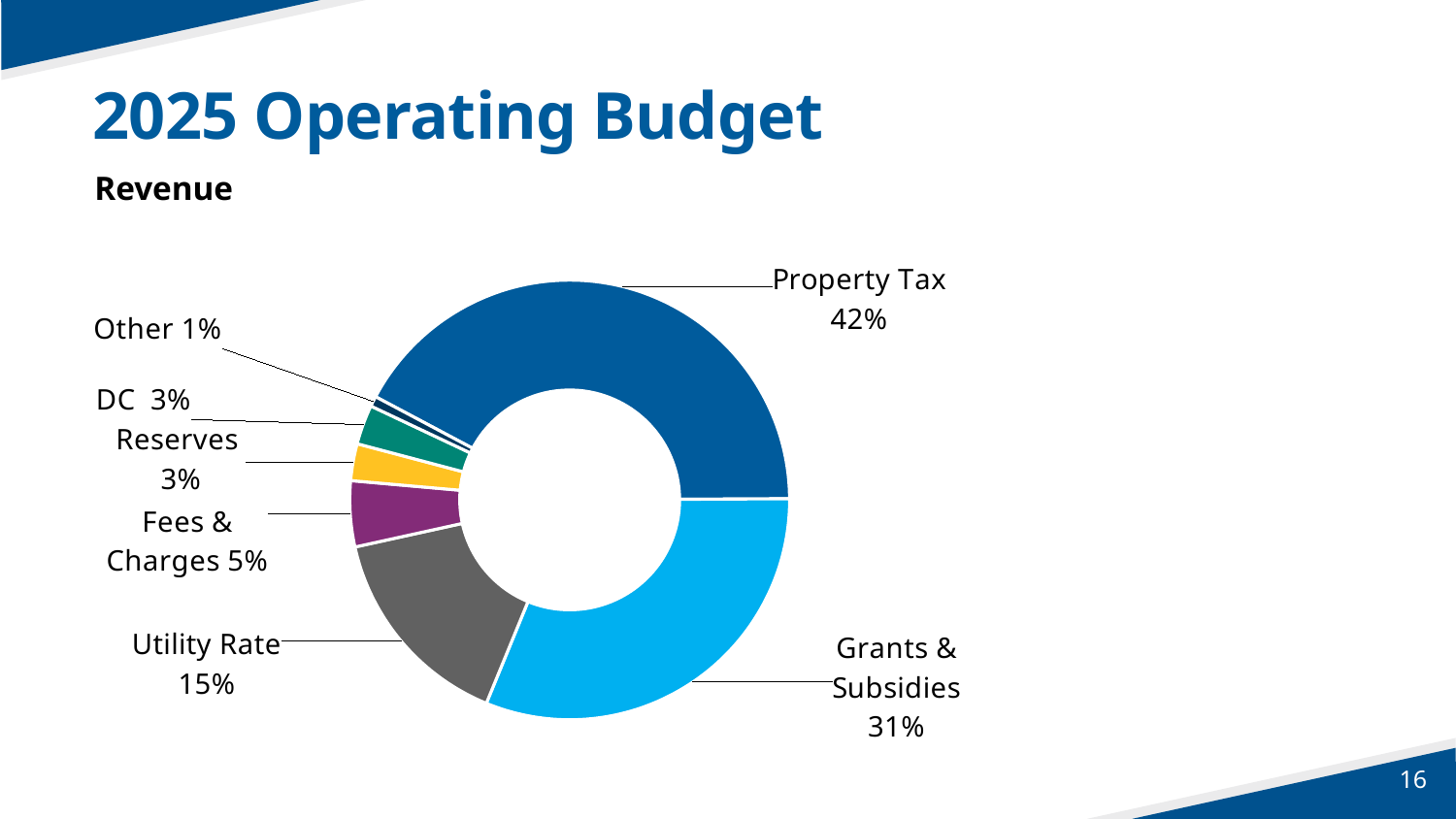
Which revenue source has the smallest share? Other How many percentage points larger is Property Tax than Grants & Subsidies? 11 Which is larger, Utility Rate or Fees & Charges? Utility Rate What share of revenue comes from Other? 1% What share of revenue comes from Utility Rate? 15% What share of revenue comes from Property Tax? 42% What share of revenue comes from Grants & Subsidies? 31% How many revenue categories are shown in the chart? 7 What is the combined share of DC and Reserves? 6% What share of revenue comes from Fees & Charges? 5% Which revenue source has the largest share? Property Tax What kind of chart is shown on the slide? Pie chart (doughnut)